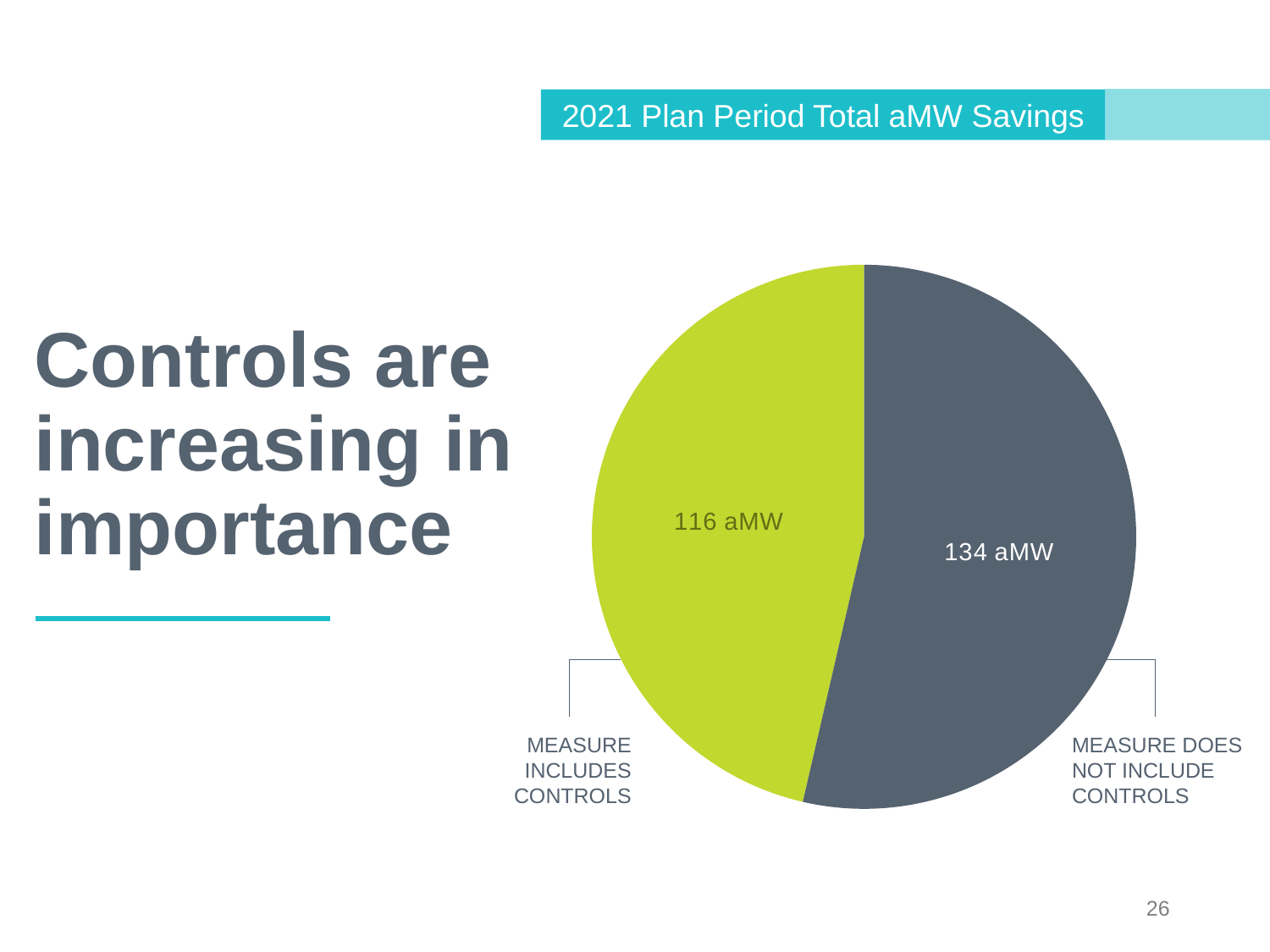
What is the value for the slice labelled "Measure includes controls"? 116 aMW What share of the total savings does the "Measure includes controls" slice represent? 46.4% Which is larger: the savings for measures that include controls or measures that do not include controls? Measure does not include controls What colour is the "Measure includes controls" slice? Green Which slice of the pie is the largest? Measure does not include controls How many slices does the pie chart have? 2 Which slice of the pie is the smallest? Measure includes controls What is the value for the slice labelled "Measure does not include controls"? 134 aMW What is the total aMW savings across both slices of the pie? 250 aMW What is the difference in aMW between the "Measure does not include controls" slice and the "Measure includes controls" slice? 18 aMW What is the title of the chart? 2021 Plan Period Total aMW Savings What type of chart is shown on the slide? Pie chart